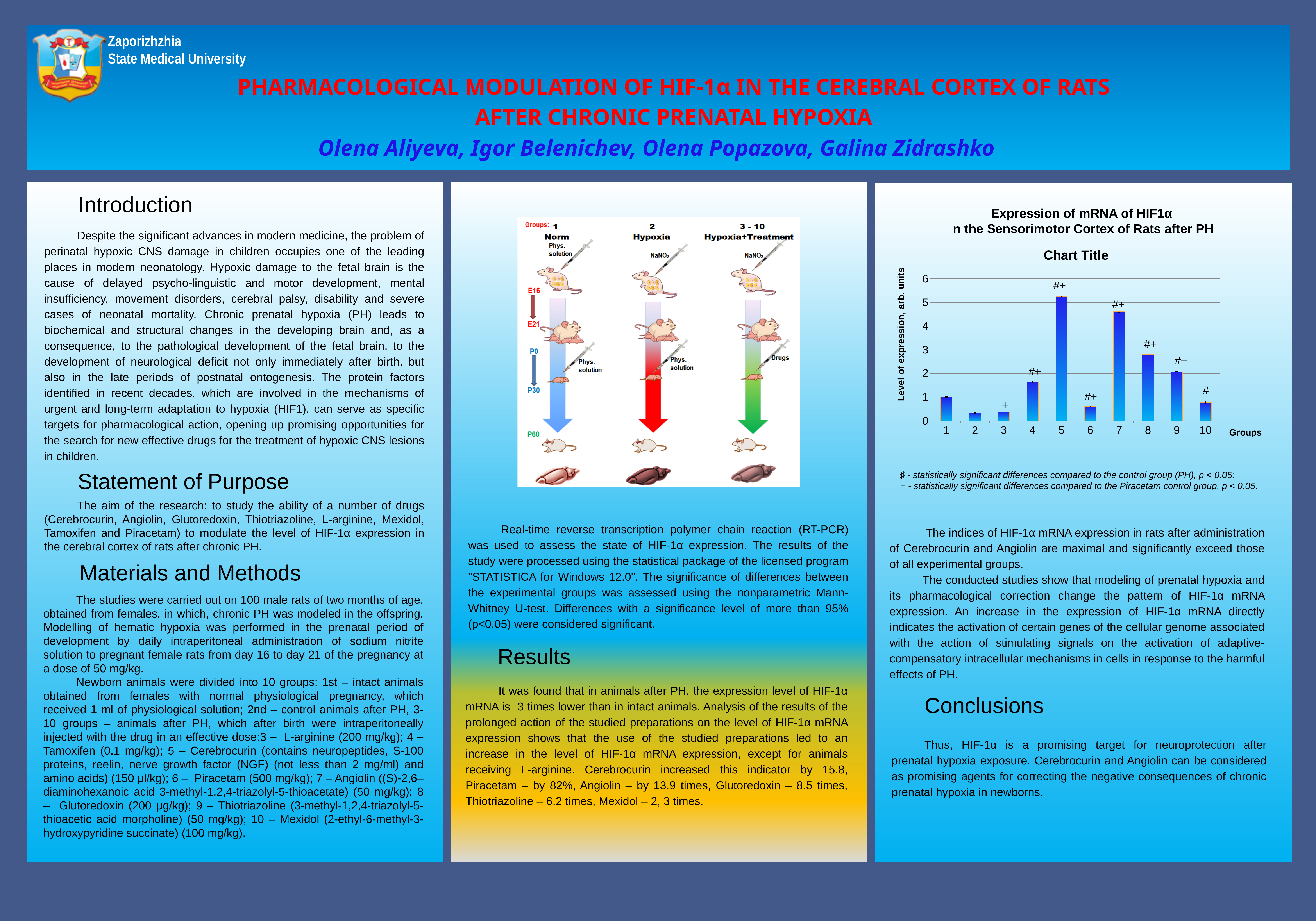
What kind of chart is shown on the slide? bar chart How many groups are plotted along the x axis of the chart? 10 Is the value for group 5 greater or less than 5? greater Is the value for group 6 greater or less than 1? less Which has a higher level of expression, group 8 or group 9? group 8 Is the value for group 7 greater or less than 4? greater Which has a higher level of expression, group 4 or group 10? group 4 Which group has the highest level of expression in the chart? 5 What is the label of the vertical axis of the chart? Level of expression, arb. units Which has a higher level of expression, group 5 or group 7? group 5